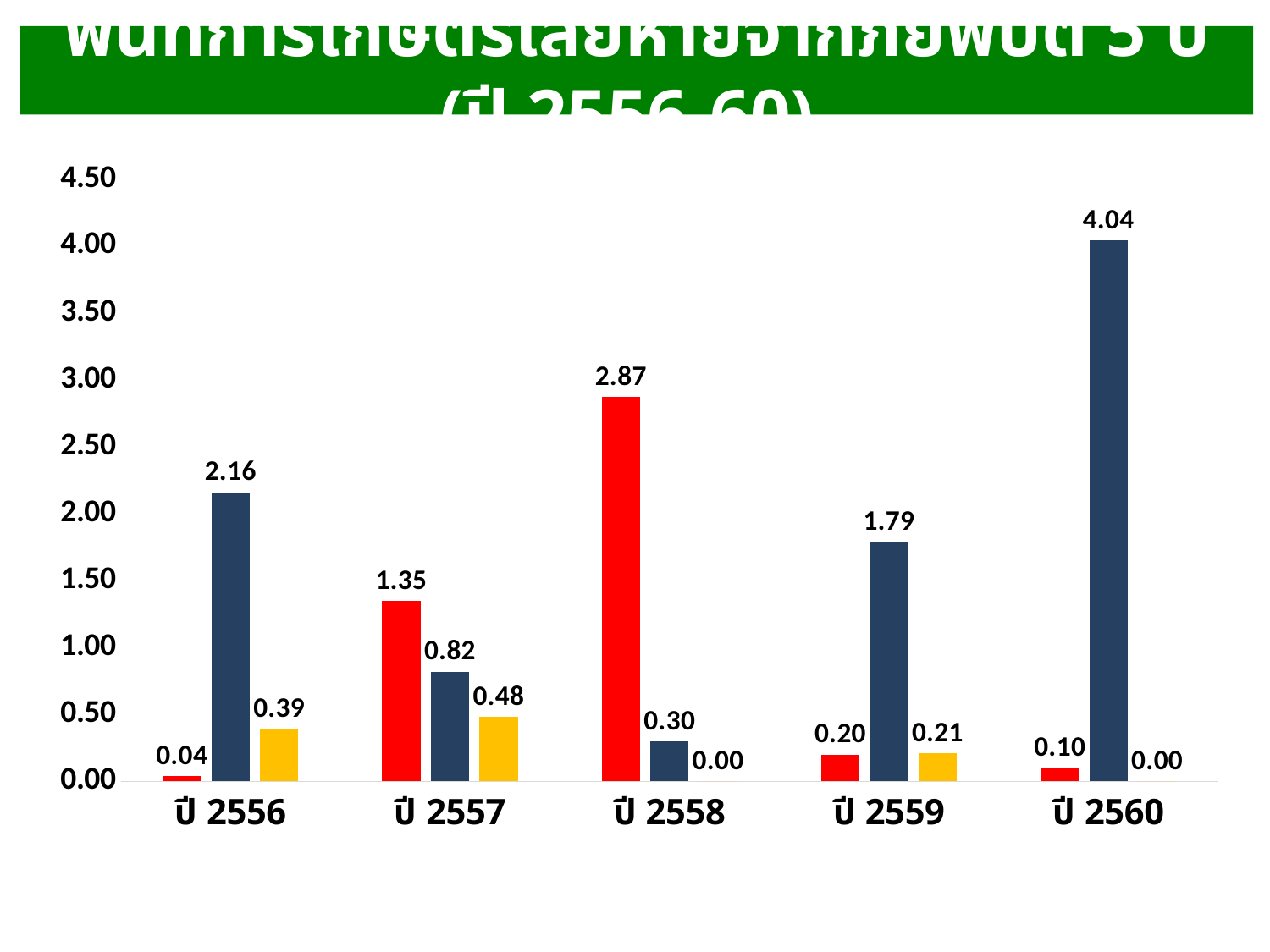
Which year has the lowest red bar? ปี 2556 How many bars are shown for each year category? 3 What is the value of the yellow bar for ปี 2557? 0.48 What kind of chart is shown on the slide? bar chart What is the difference between the dark blue bar for ปี 2560 and the dark blue bar for ปี 2556? 1.88 How many year categories are shown on the x axis? 5 Is the value of the red bar for ปี 2558 greater or less than 2.50? greater Which year has the highest dark blue bar? ปี 2560 What is the value of the yellow bar for ปี 2560? 0.00 What is the value of the dark blue bar for ปี 2560? 4.04 Which is larger for ปี 2557, the red bar or the dark blue bar? the red bar What is the value of the red bar for ปี 2558? 2.87